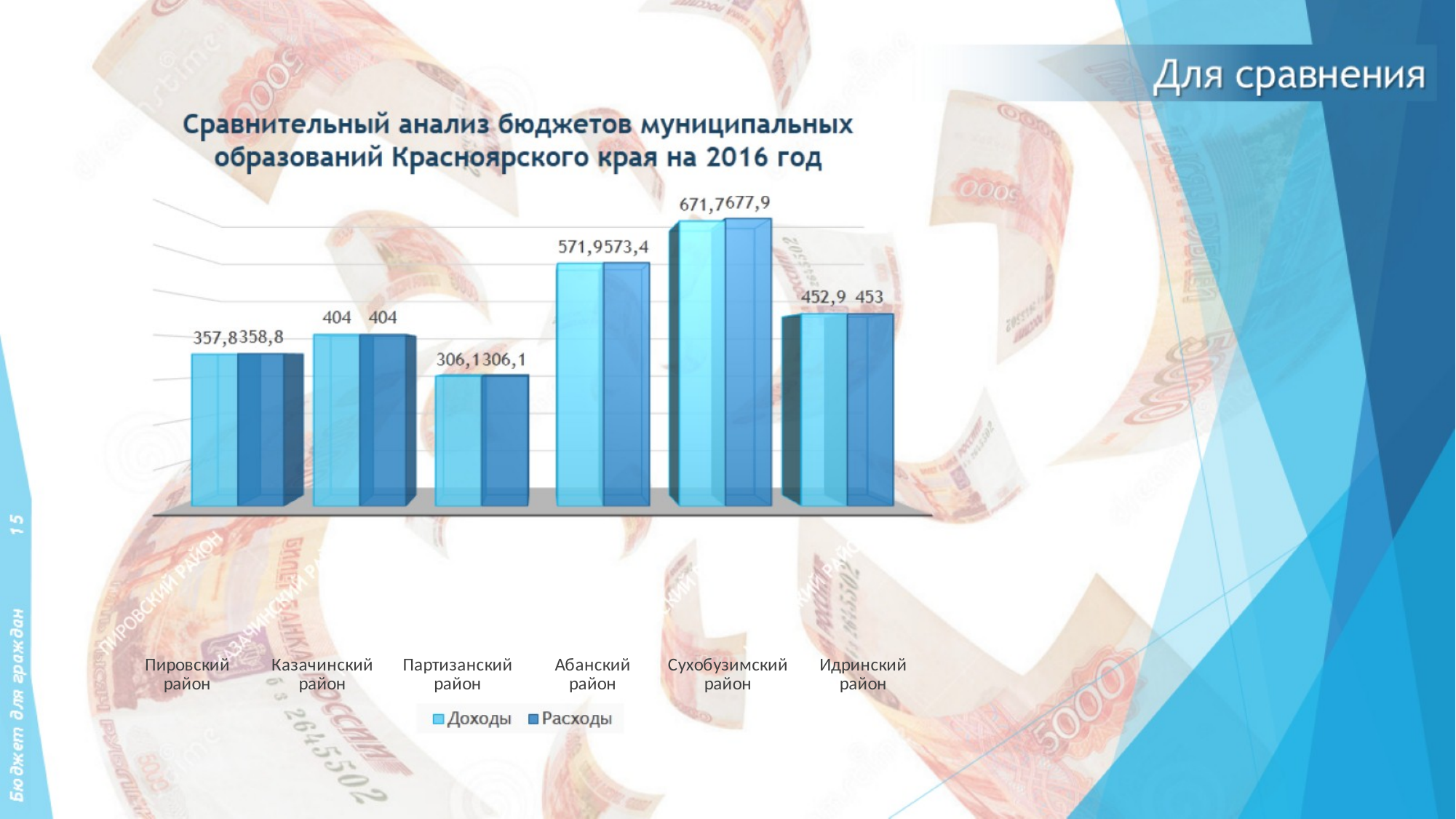
What is the Расходы value for Идринский район? 453 What is the Доходы value for Абанский район? 571,9 How many districts are shown on the chart? 6 What is the Расходы value for Сухобузимский район? 677,9 What is the Доходы value for Пировский район? 357,8 Which district has the highest Доходы value? Сухобузимский район How many series does the legend list? 2 Which district has the lowest Расходы value? Партизанский район What kind of chart is shown on the slide? Bar chart What are the two series named in the chart legend? Доходы and Расходы What is the difference between the Расходы and Доходы values for Сухобузимский район? 6,2 Which is larger: the Доходы value for Казачинский район or the Доходы value for Идринский район? Идринский район